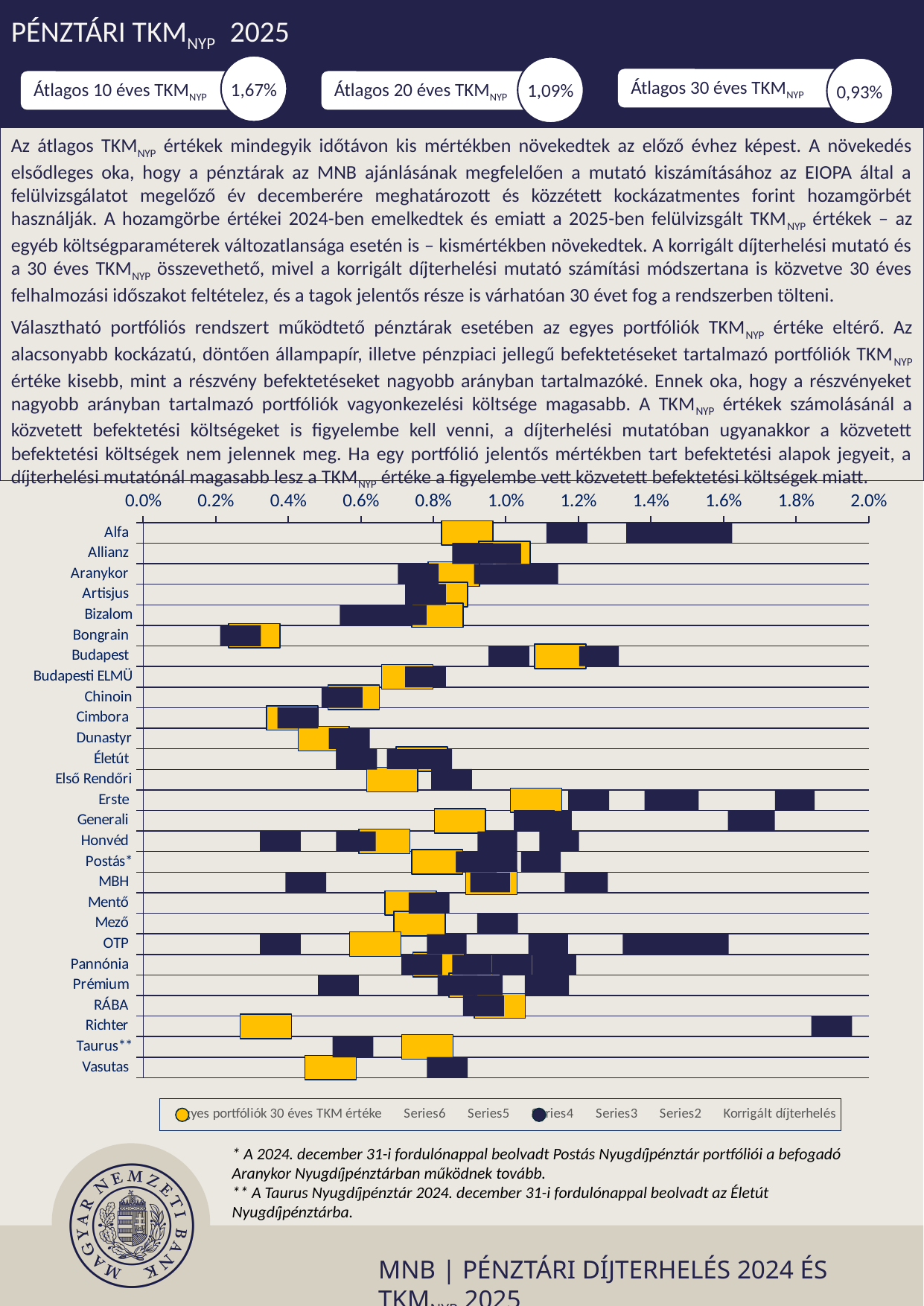
Is the yellow bar for Bongrain greater or less than 0.4%? less Is the yellow bar for Richter greater or less than 0.6%? less Is the rightmost bar for Erste greater or less than 1.6%? greater How many pension funds (categories) are listed on the vertical axis of the chart? 27 How many series does the chart legend list? 7 What is the label of the last entry in the chart legend? Korrigált díjterhelés Which fund has a bar extending furthest to the right on the chart? Richter What is the highest tick value shown on the chart's horizontal axis? 2.0% What kind of chart is shown on the slide? bar chart Which fund has the bar positioned furthest to the left on the chart? Bongrain